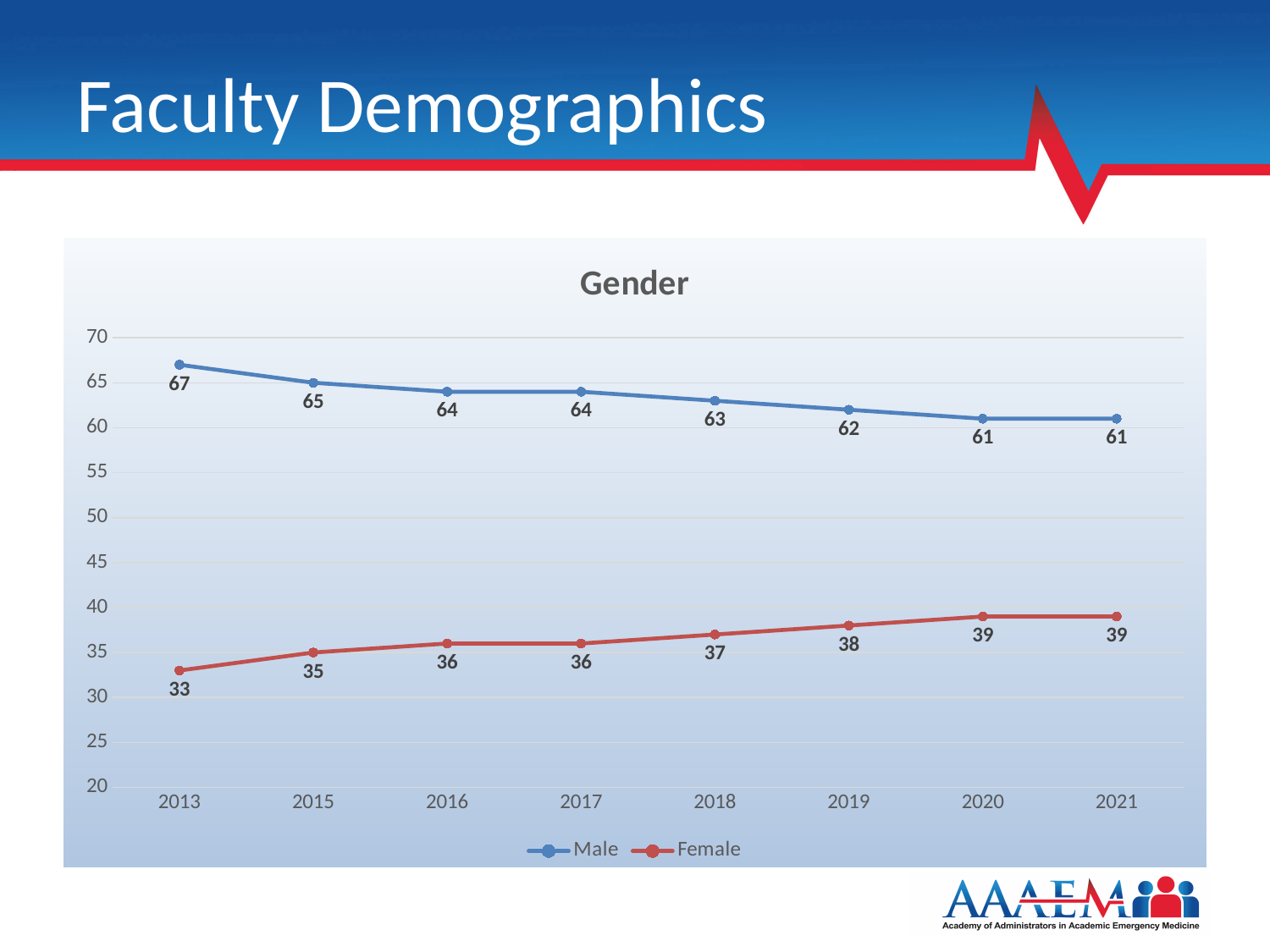
What is the difference between the Male value in 2013 and the Male value in 2021? 6 What is the Male value for 2021? 61 What is the Male value for 2013? 67 In which year is the Male value highest? 2013 What is the difference between the Male and Female values in 2013? 34 How many years are shown on the x axis? 8 What is the Female value for 2019? 38 What kind of chart is shown? Line chart In which year is the Female value lowest? 2013 How many series does the legend list? 2 Does the Female series rise or fall from 2013 to 2021? Rise Which is larger in 2018, the Male value or the Female value? Male